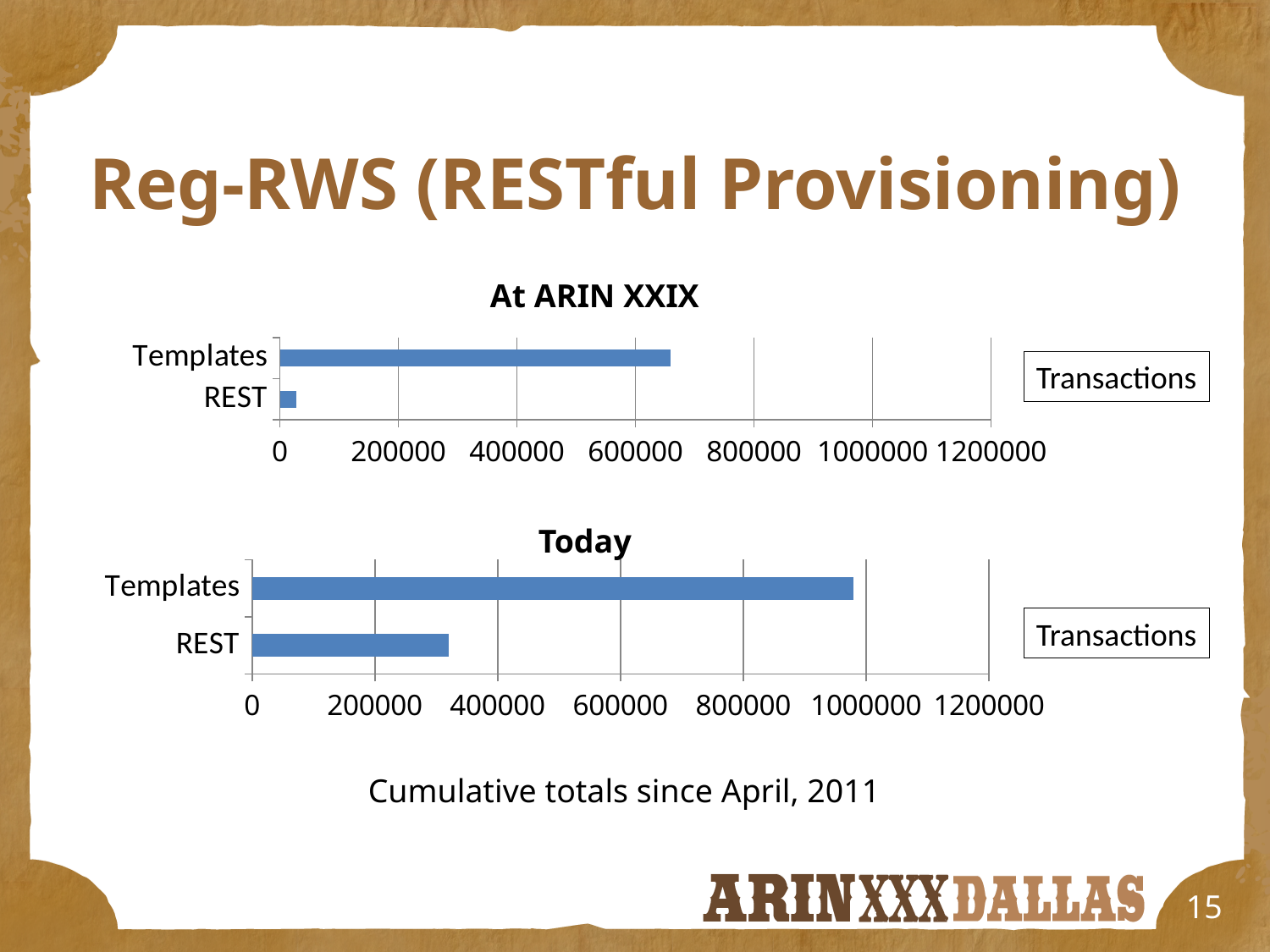
In the 'Today' chart, is the value for Templates greater or less than 800000? greater In the 'Today' chart, is the value for REST greater or less than 200000? greater What kind of chart is the 'Today' chart? bar chart In the 'At ARIN XXIX' chart, is the value for REST greater or less than 200000? less How many series does the legend of the 'At ARIN XXIX' chart list? 1 In the 'Today' chart, which category has the lowest value? REST How many categories are shown in the 'Today' chart? 2 What kind of chart is the 'At ARIN XXIX' chart? bar chart In the 'At ARIN XXIX' chart, which category has the highest value? Templates What is the legend entry shown for the 'Today' chart? Transactions